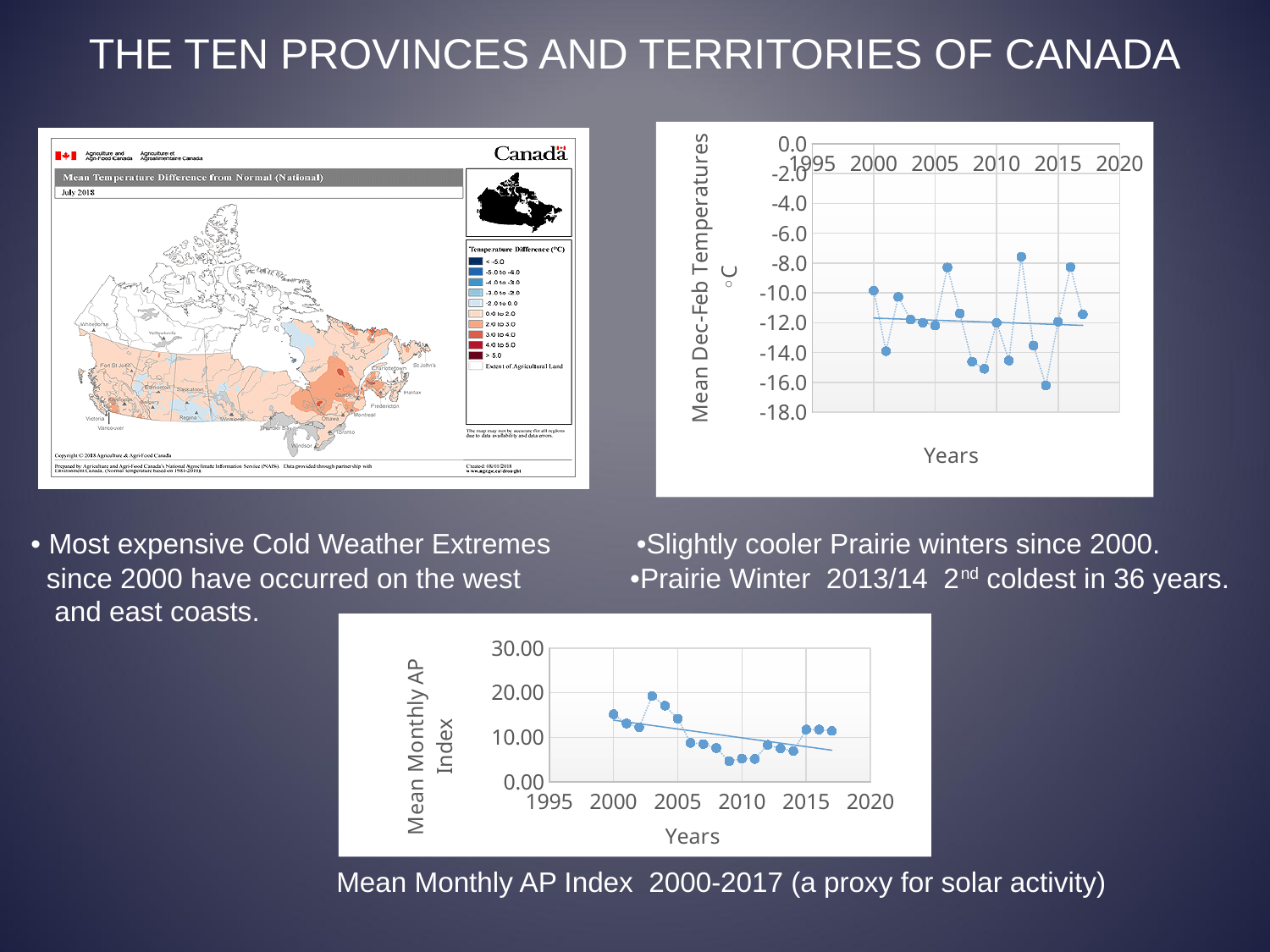
In the top-right Mean Dec-Feb Temperatures chart, which year has the highest plotted temperature? 2012 What is the y-axis label of the bottom chart? Mean Monthly AP Index What kind of chart is the top-right chart of Mean Dec-Feb Temperatures? scatter plot In the top-right Mean Dec-Feb Temperatures chart, does the trend line rise or fall from 2000 to 2017? fall In the top-right Mean Dec-Feb Temperatures chart, which year has the lowest plotted temperature? 2014 In the bottom Mean Monthly AP Index chart, which year has the highest plotted value? 2003 What kind of chart is the bottom chart of Mean Monthly AP Index? scatter plot In the top-right Mean Dec-Feb Temperatures chart, which is larger, the value for 2000 or the value for 2001? 2000 In the bottom Mean Monthly AP Index chart, is the value for 2009 greater or less than 10.00? less In the top-right Mean Dec-Feb Temperatures chart, is the value for 2012 greater or less than -10.0? greater In the top-right Mean Dec-Feb Temperatures chart, is the value for 2014 greater or less than -14.0? less In the bottom Mean Monthly AP Index chart, does the trend line rise or fall from 2000 to 2017? fall